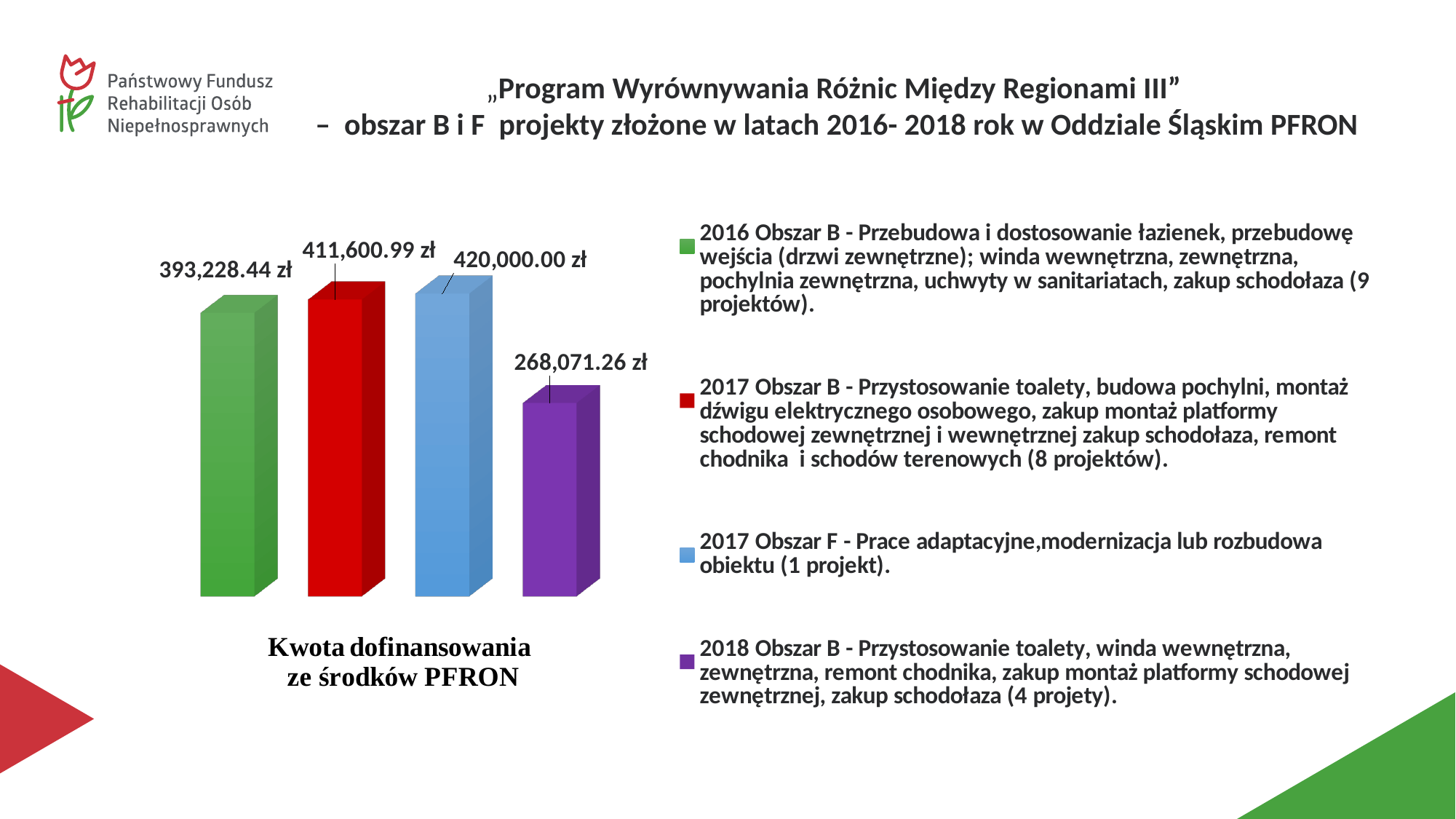
What is the difference between the values for 2016 Obszar B and 2018 Obszar B? 125,157.18 zł How many series does the legend list? 4 Which is larger, the value for 2017 Obszar B or the value for 2016 Obszar B? 2017 Obszar B What is the difference between the values for 2017 Obszar F and 2017 Obszar B? 8,399.01 zł What is the value for 2017 Obszar B? 411,600.99 zł What kind of chart is shown on the slide? Bar chart How many bars are plotted in the chart? 4 What is the value for 2016 Obszar B? 393,228.44 zł What is the value for 2018 Obszar B? 268,071.26 zł Which series has the highest value? 2017 Obszar F What is the value for 2017 Obszar F? 420,000.00 zł Which series has the lowest value? 2018 Obszar B